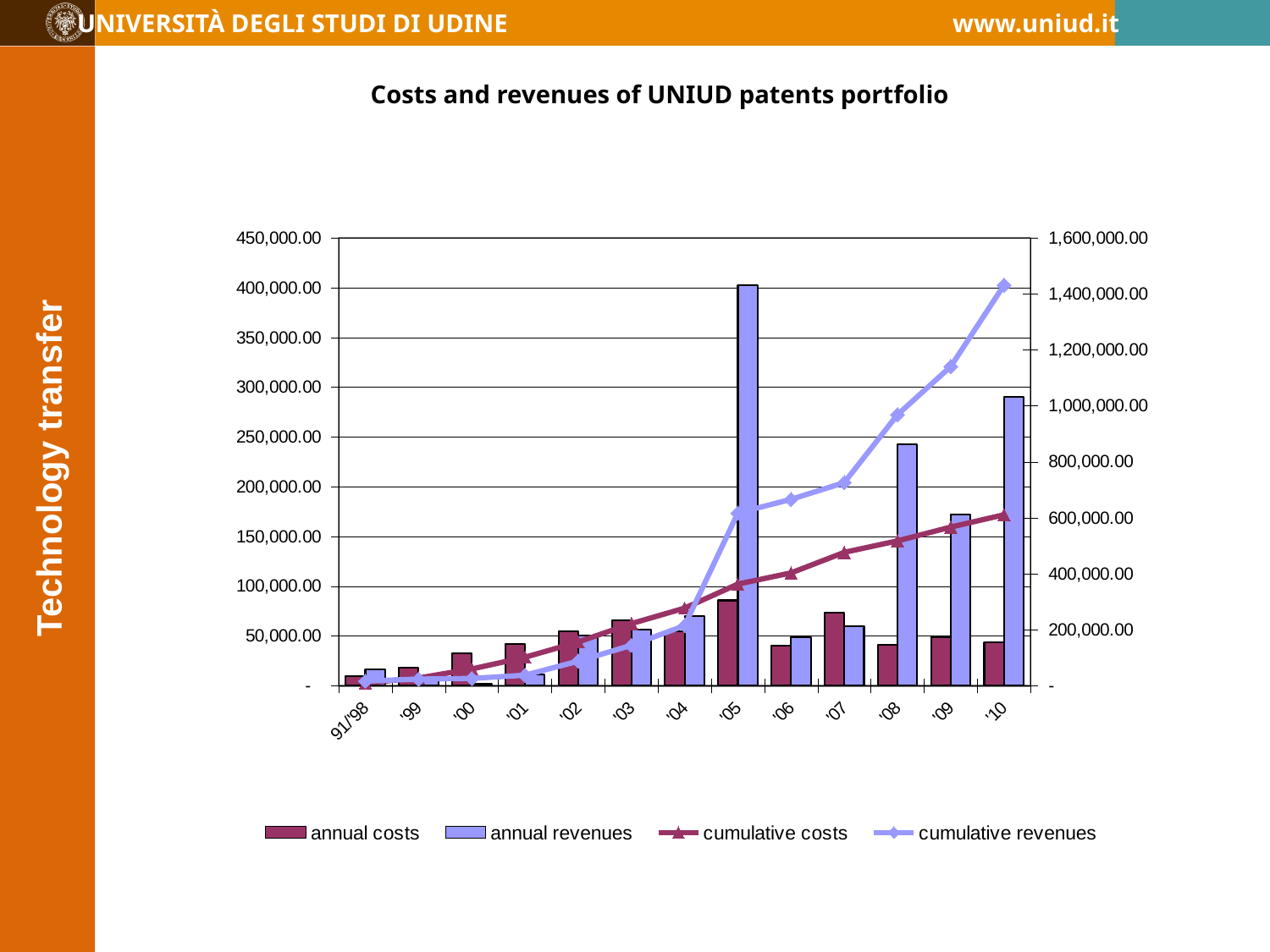
Is the value of annual costs for '06 greater or less than 50,000.00? less What is the title of the chart? Costs and revenues of UNIUD patents portfolio Do cumulative revenues rise or fall from 91/'98 to '10? rise Is the value of annual revenues for '05 greater or less than 350,000.00? greater In which year are annual costs highest? '05 What kind of chart is this? Combined bar and line chart Is the value of cumulative costs for '10 (right axis) greater or less than 400,000.00? greater How many year categories are shown on the x axis? 13 Which is larger, annual revenues for '08 or annual revenues for '09? '08 In which year are annual revenues highest? '05 How many series does the legend list? 4